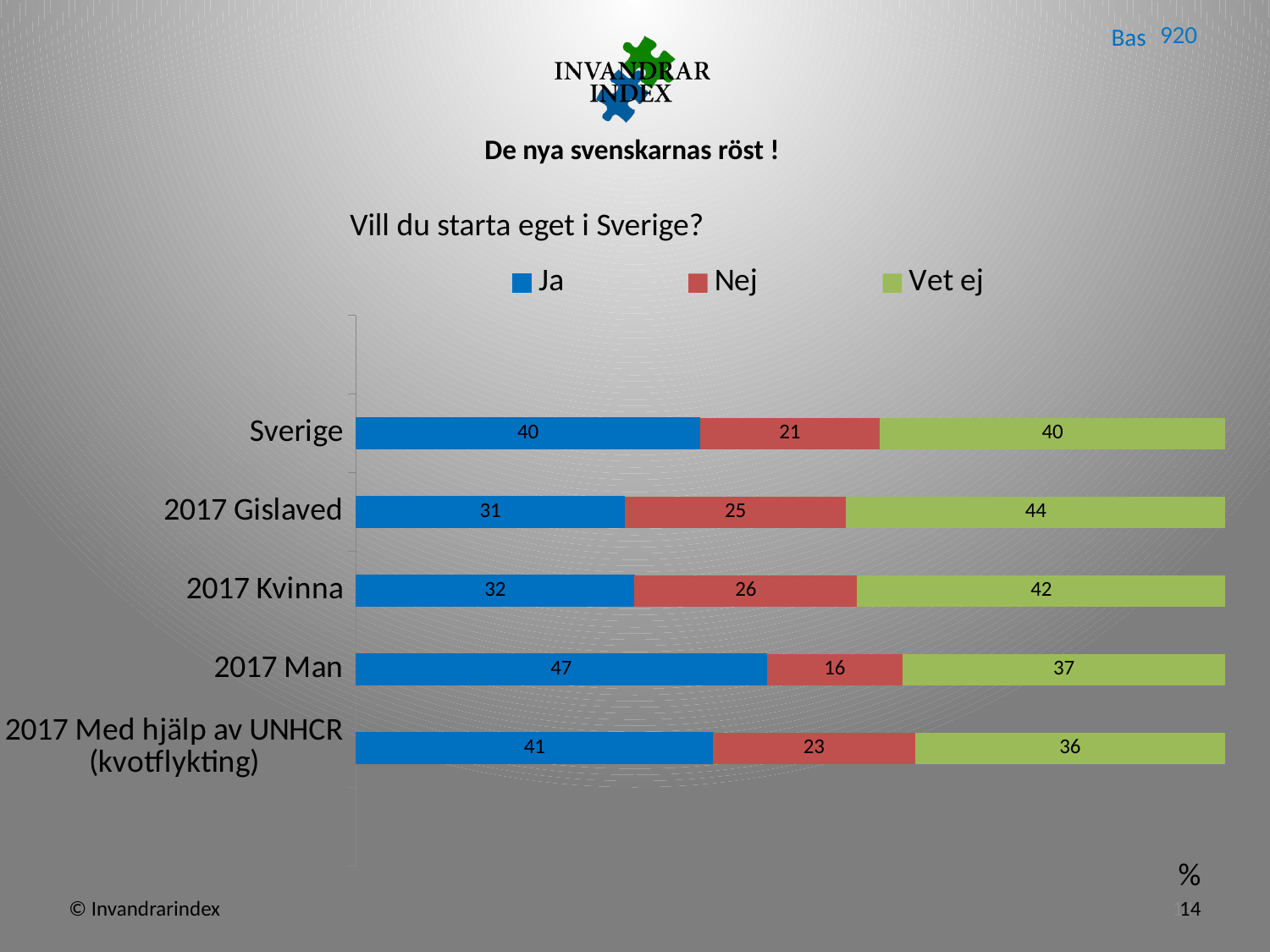
What is the value of "Nej" for 2017 Gislaved? 25 What is the value of "Ja" for 2017 Man? 47 Which is larger: the "Vet ej" value for 2017 Gislaved or for Sverige? 2017 Gislaved What is the value of "Ja" for 2017 Med hjälp av UNHCR (kvotflykting)? 41 What is the total of the stacked bar for Sverige? 101 What is the difference between the "Ja" values for 2017 Man and 2017 Kvinna? 15 What kind of chart is shown on the slide? Stacked bar chart What is the value of "Vet ej" for 2017 Kvinna? 42 Which category has the highest "Ja" value? 2017 Man How many series does the legend list? 3 How many categories are shown on the chart? 5 Which category has the lowest "Nej" value? 2017 Man